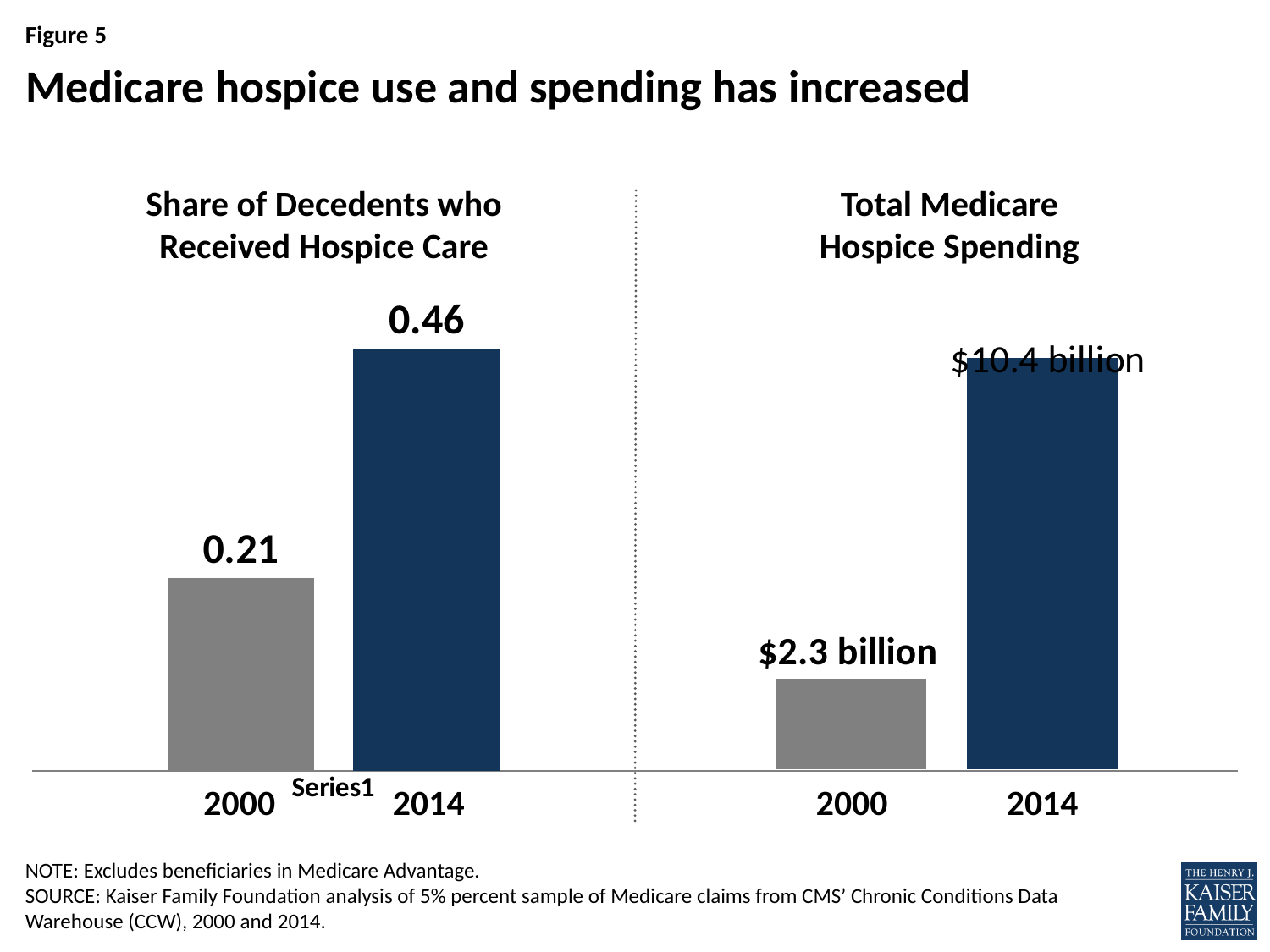
How many bars are in the 'Share of Decedents who Received Hospice Care' chart? 2 In the 'Total Medicare Hospice Spending' chart, which year has the lower value? 2000 What type of chart is the 'Total Medicare Hospice Spending' chart? bar chart In the 'Share of Decedents who Received Hospice Care' chart, what is the value for 2014? 0.46 In the 'Total Medicare Hospice Spending' chart, is the value for 2014 larger or smaller than the value for 2000? larger In the 'Share of Decedents who Received Hospice Care' chart, what is the value for 2000? 0.21 In the 'Share of Decedents who Received Hospice Care' chart, do the values rise or fall from 2000 to 2014? rise In the 'Total Medicare Hospice Spending' chart, what is the value for 2000? $2.3 billion In the 'Total Medicare Hospice Spending' chart, what is the value for 2014? $10.4 billion In the 'Total Medicare Hospice Spending' chart, what is the difference between the 2014 and 2000 values? $8.1 billion In the 'Share of Decedents who Received Hospice Care' chart, which year has the higher value? 2014 In the 'Share of Decedents who Received Hospice Care' chart, what is the difference between the 2014 and 2000 values? 0.25